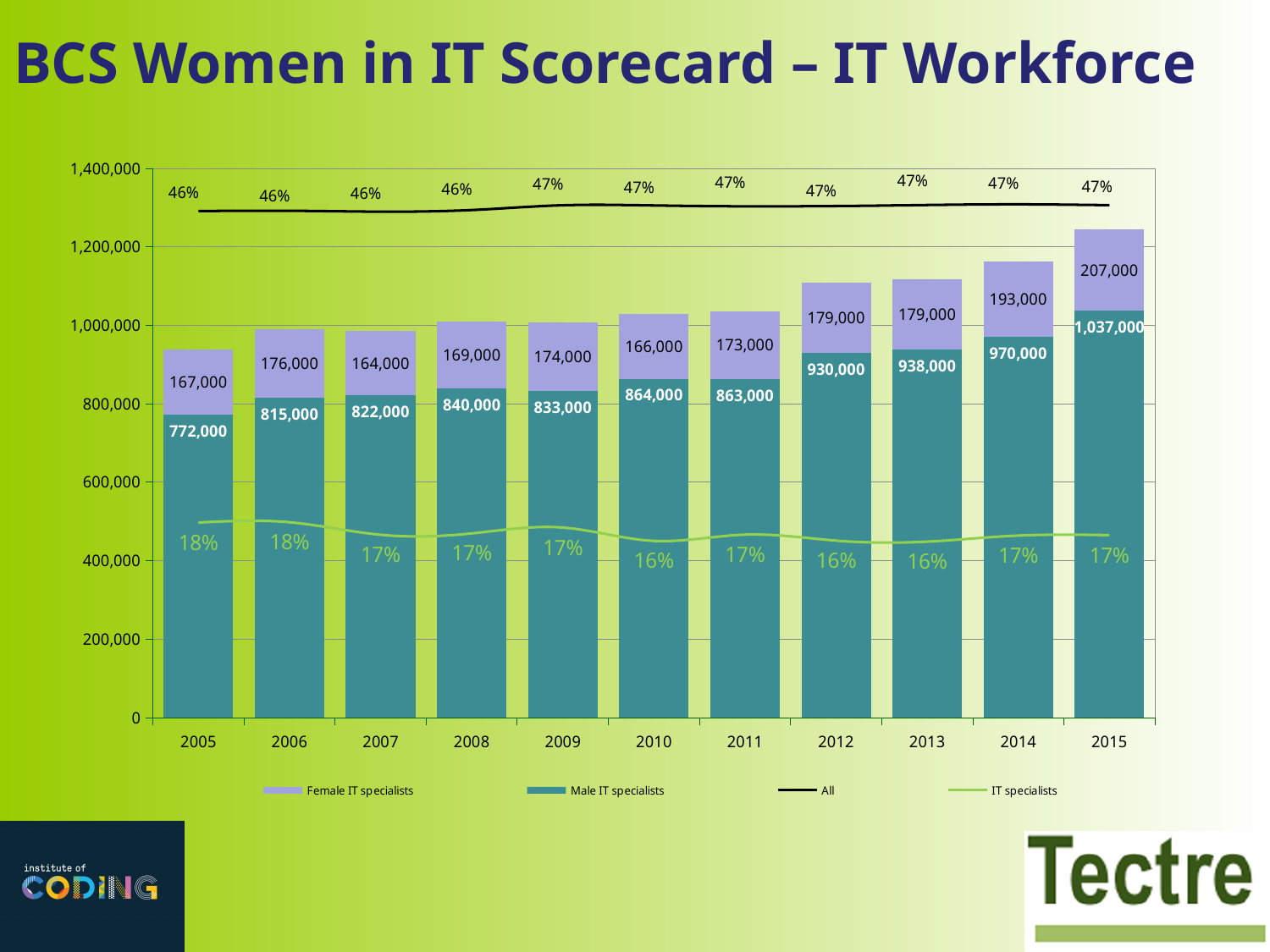
What is the total of the stacked bar for 2015 (Male plus Female IT specialists)? 1,244,000 How many series does the legend list? 4 In which year is the number of Female IT specialists lowest? 2007 What percentage does the All line show for 2010? 47% In which year is the number of Male IT specialists highest? 2015 What is the difference between the Female IT specialists values for 2015 and 2005? 40,000 How many years are shown on the x axis? 11 Do the Male IT specialists values generally rise or fall from 2005 to 2015? rise What percentage does the IT specialists line show for 2005? 18% Which year has the larger Male IT specialists value, 2008 or 2009? 2008 What is the value for Female IT specialists in 2014? 193,000 What is the value for Male IT specialists in 2015? 1,037,000